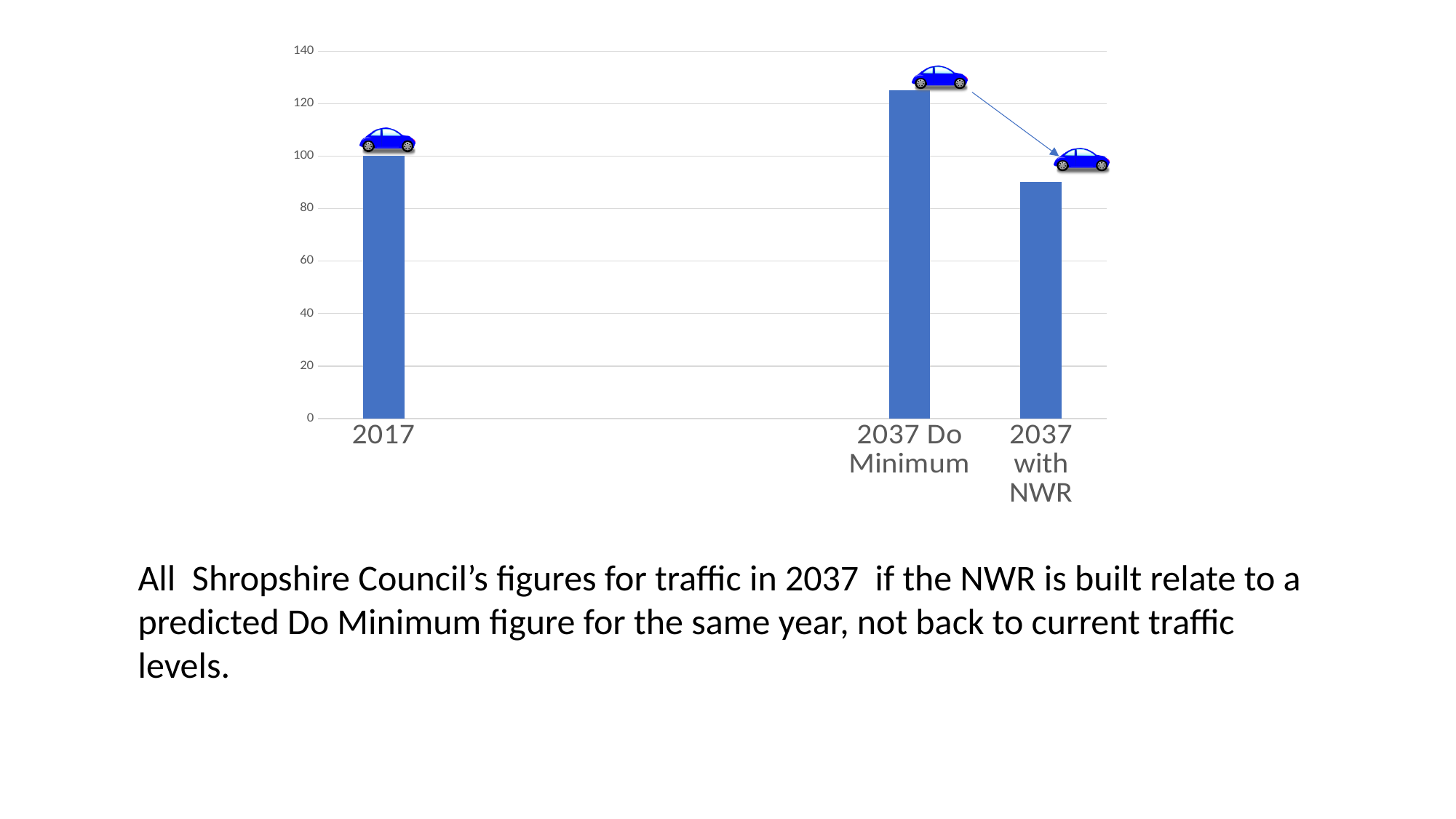
Is the value for 2037 with NWR greater or less than 80? greater What is the value for 2017? 100 Is the value for 2037 Do Minimum greater or less than 120? greater Which category has the highest bar? 2037 Do Minimum How many categories are plotted on the chart? 3 Does the value rise or fall from 2037 Do Minimum to 2037 with NWR? fall Which is larger, the value for 2017 or the value for 2037 Do Minimum? 2037 Do Minimum Which is larger, the value for 2017 or the value for 2037 with NWR? 2017 Is the value for 2037 with NWR greater or less than 100? less What is the highest value shown on the vertical axis? 140 Which category has the lowest bar? 2037 with NWR What kind of chart is shown on the slide? bar chart